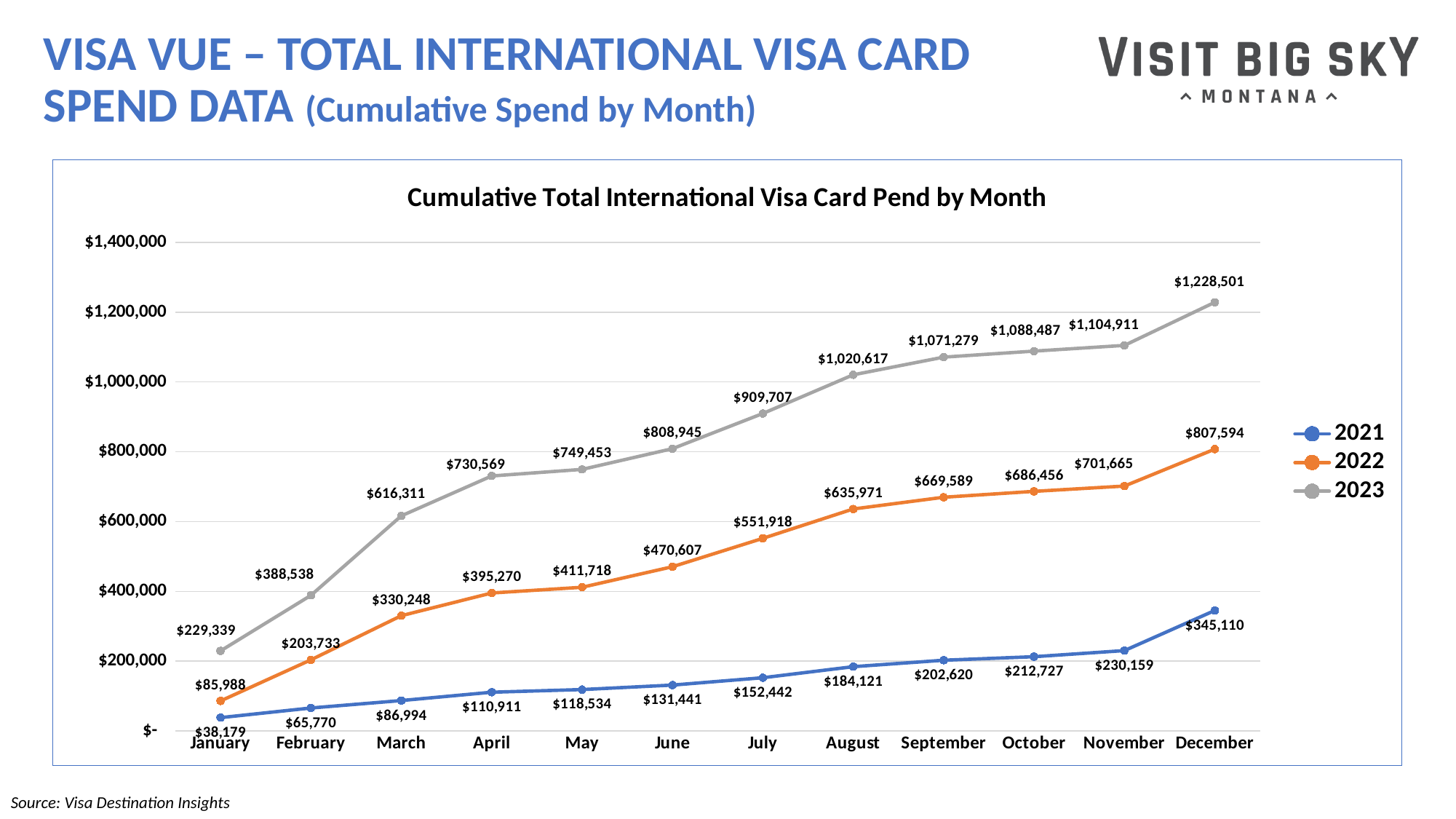
What is the cumulative spend for 2023 in August? $1,020,617 What type of chart is shown on the slide? Line chart What is the cumulative spend for 2022 in June? $470,607 Which is larger, the 2022 value in March or the 2023 value in February? 2023 value in February Which year has the lowest cumulative spend in January? 2021 What is the cumulative spend for 2021 in March? $86,994 Which year has the highest cumulative spend in December? 2023 How many months are plotted along the x axis? 12 How many series does the legend list? 3 What is the cumulative spend for 2023 in December? $1,228,501 What is the difference between the December values for 2023 and 2022? $420,907 Do the 2022 values rise or fall from January to December? Rise